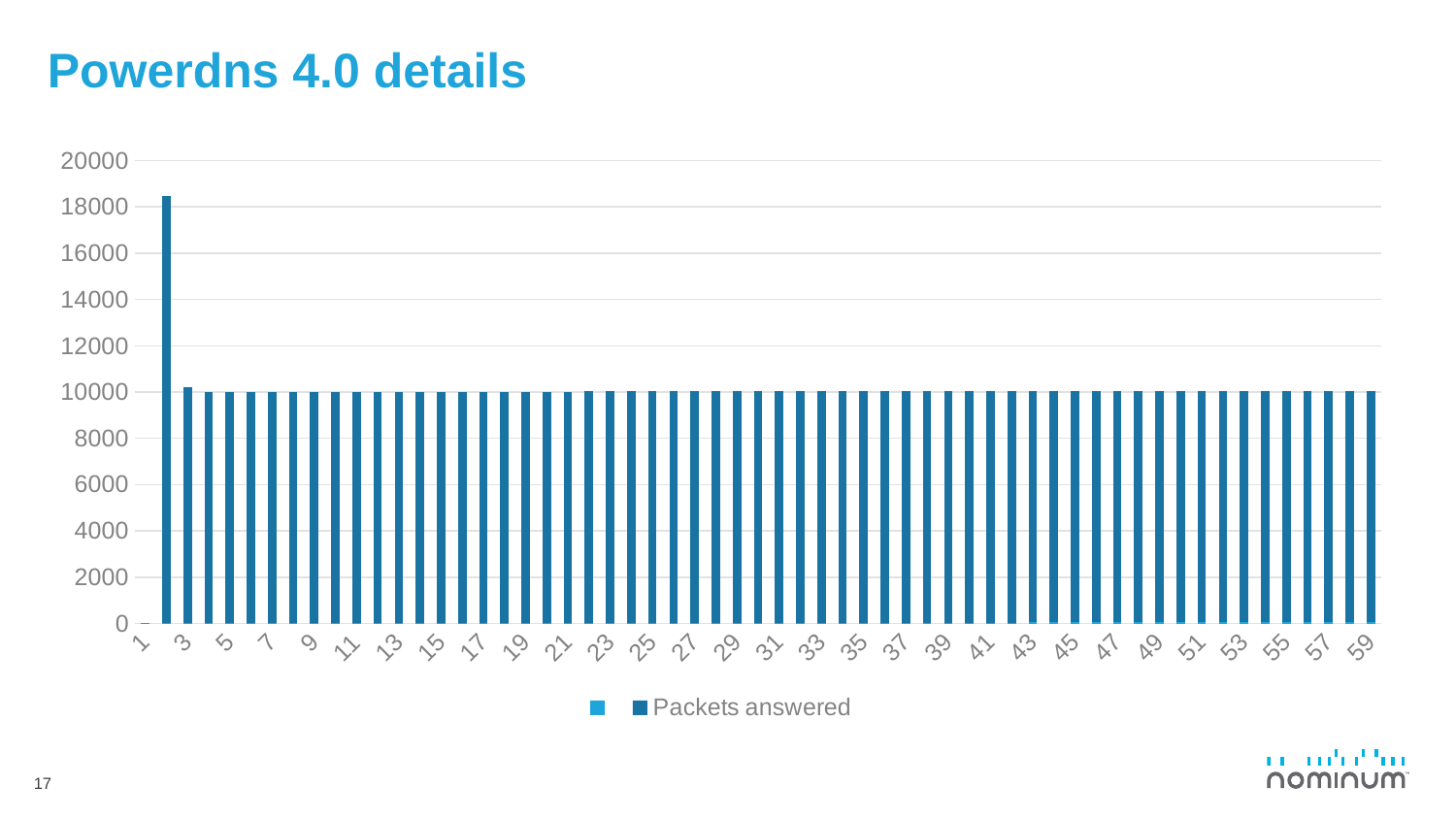
Is the value for category 2 greater or less than 16000? greater Which category has the highest value in the chart? 2 Which category has the lowest value in the chart? 1 Do the values rise or fall from category 2 to category 3? fall Which is larger, the value for category 2 or the value for category 3? category 2 What is the title of the slide containing the chart? Powerdns 4.0 details What is the highest value shown on the y axis? 20000 What kind of chart is shown on the slide? bar chart Is the value for category 1 greater or less than 2000? less What is the name of the series shown in the legend? Packets answered Is the value for category 3 greater or less than 8000? greater